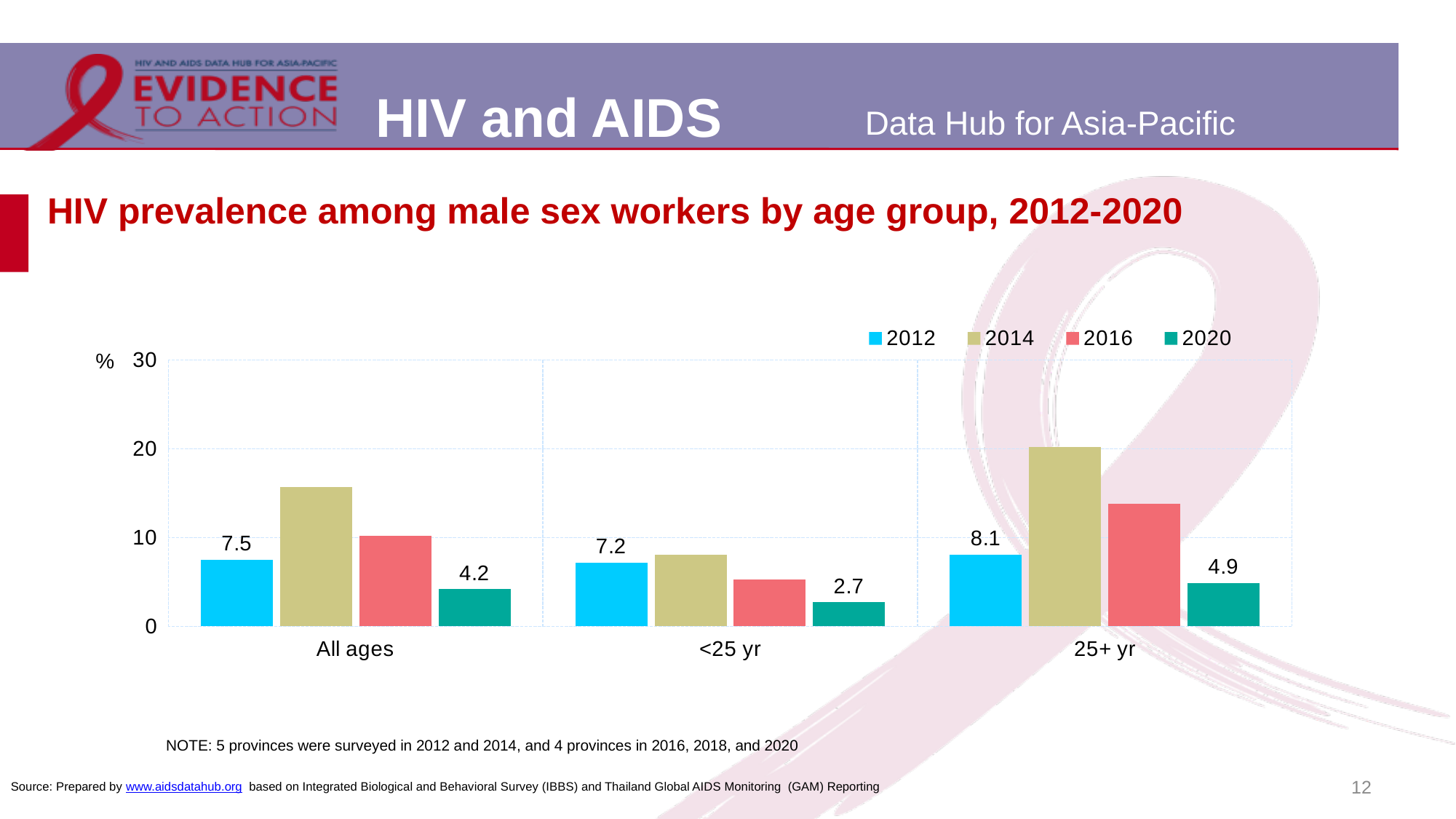
Which age group has the highest HIV prevalence in 2020? 25+ yr What is the HIV prevalence among male sex workers of all ages in 2012? 7.5 What is the HIV prevalence among male sex workers aged 25+ yr in 2012? 8.1 What is the HIV prevalence among male sex workers aged <25 yr in 2020? 2.7 What is the difference between the 2012 and 2020 HIV prevalence for all ages? 3.3 What type of chart is shown on the slide? Bar chart Is the 2016 HIV prevalence for the <25 yr group greater or less than 10? less How many series does the legend list? 4 Which age group has the lowest HIV prevalence in 2012? <25 yr Is the 2012 HIV prevalence for all ages larger or smaller than the 2012 value for 25+ yr? smaller What is the HIV prevalence among male sex workers aged 25+ yr in 2020? 4.9